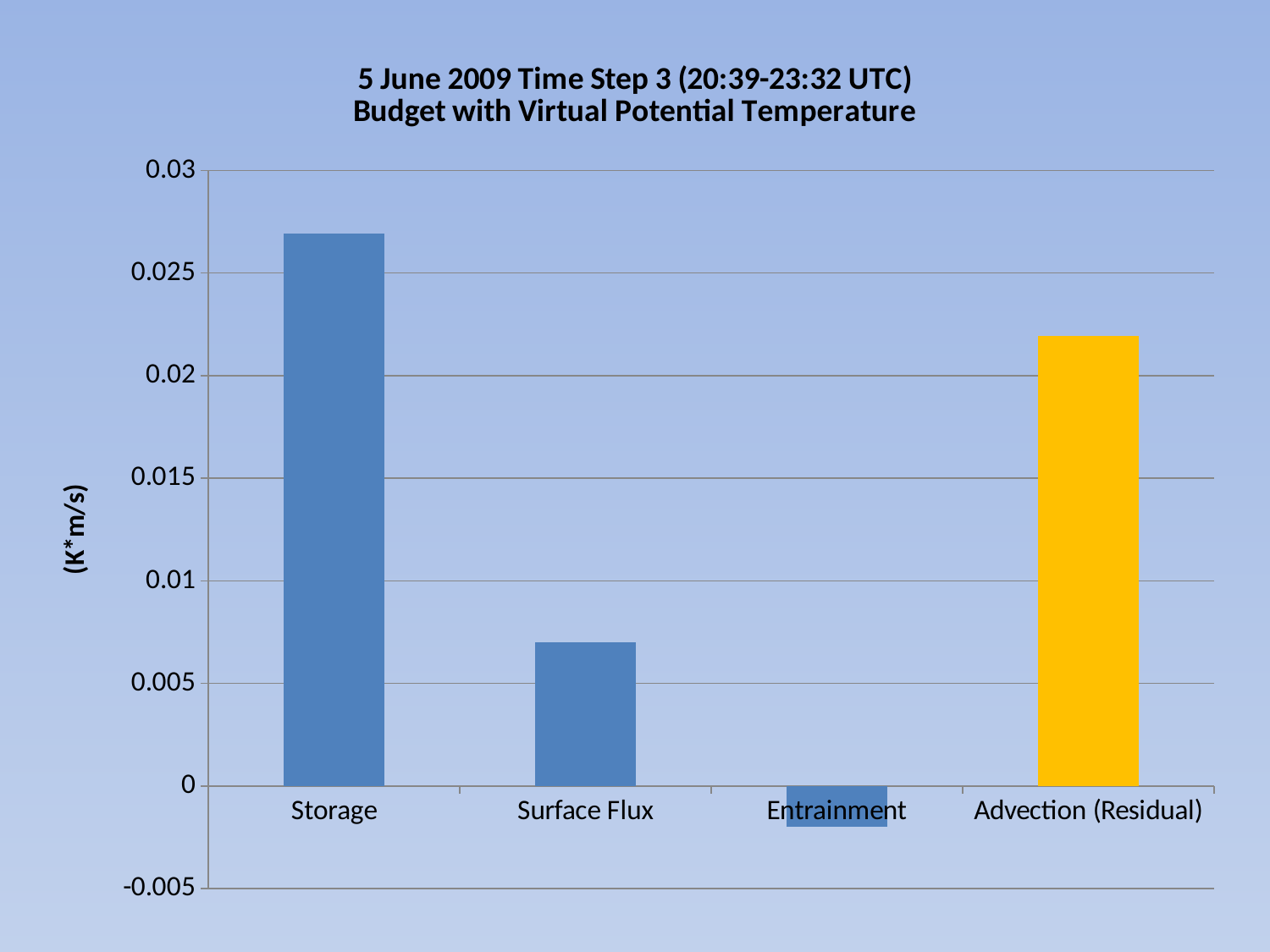
Is the value for Advection (Residual) greater or less than 0.02? greater What is the label on the y axis? (K*m/s) Which category has the highest value? Storage Which is larger, the value for Surface Flux or the value for Advection (Residual)? Advection (Residual) Is the value for Storage greater or less than 0.025? greater Which is larger, the value for Storage or the value for Advection (Residual)? Storage What kind of chart is shown on the slide? bar chart Which category has the lowest value? Entrainment Is the value for Entrainment greater or less than 0? less How many categories are plotted on the x axis? 4 Which category's bar is coloured yellow? Advection (Residual)